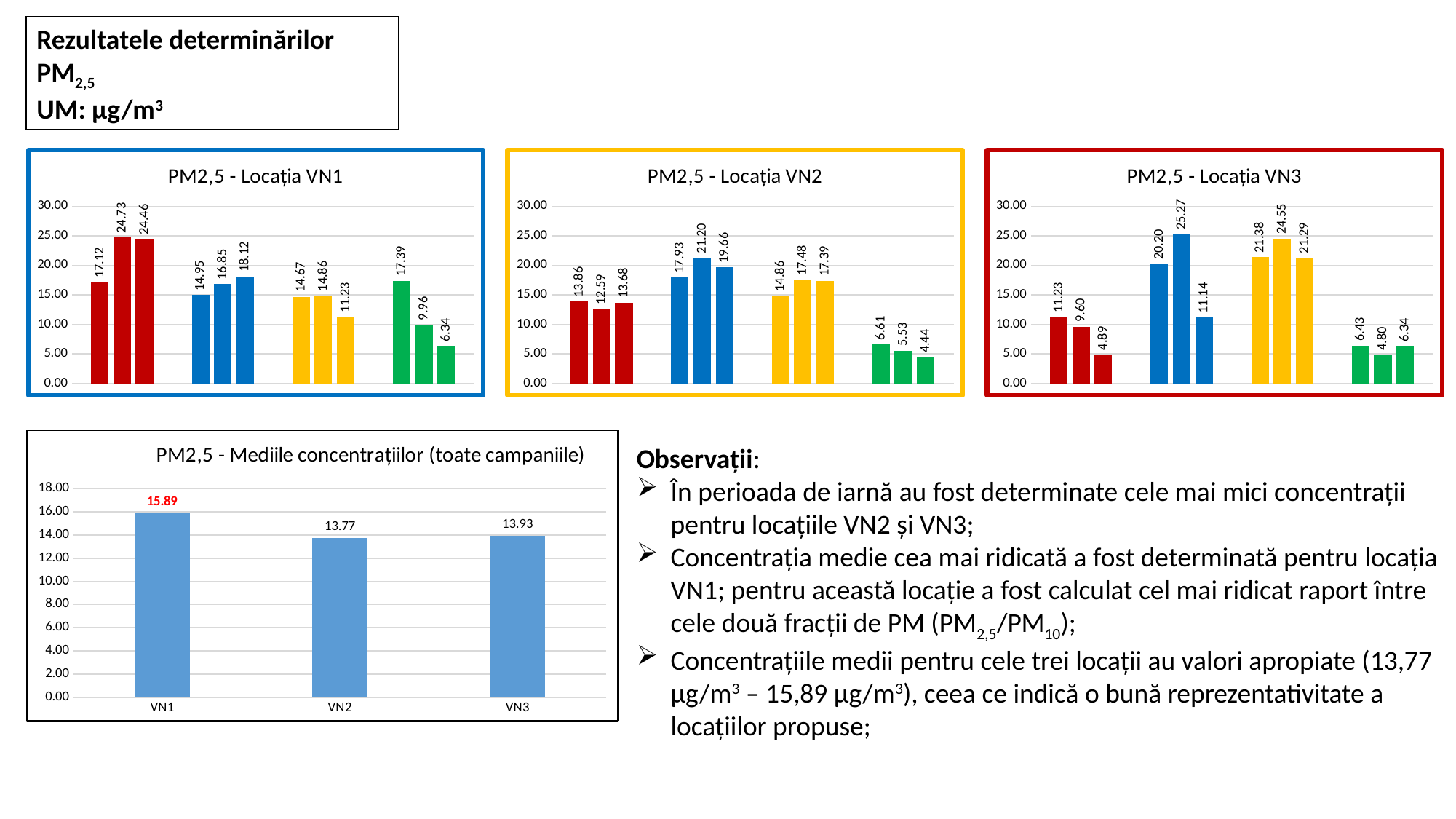
In the chart titled 'PM2,5 - Mediile concentrațiilor (toate campaniile)', what is the value for VN1? 15.89 In the chart titled 'PM2,5 - Mediile concentrațiilor (toate campaniile)', what is the value for VN2? 13.77 What kind of chart is 'PM2,5 - Mediile concentrațiilor (toate campaniile)'? bar chart In the chart titled 'PM2,5 - Mediile concentrațiilor (toate campaniile)', what is the difference between the values for VN1 and VN2? 2.12 In the chart titled 'PM2,5 - Locația VN1', what is the highest value shown? 24.73 In the chart titled 'PM2,5 - Mediile concentrațiilor (toate campaniile)', which location has the highest value? VN1 In the chart titled 'PM2,5 - Locația VN3', what is the highest value shown? 25.27 In the chart titled 'PM2,5 - Locația VN3', how many bars are plotted? 12 In the chart titled 'PM2,5 - Mediile concentrațiilor (toate campaniile)', which is larger, the value for VN3 or the value for VN2? VN3 In the chart titled 'PM2,5 - Mediile concentrațiilor (toate campaniile)', how many locations are shown on the x axis? 3 In the chart titled 'PM2,5 - Mediile concentrațiilor (toate campaniile)', which location has the lowest value? VN2 In the chart titled 'PM2,5 - Locația VN2', what is the lowest value shown? 4.44